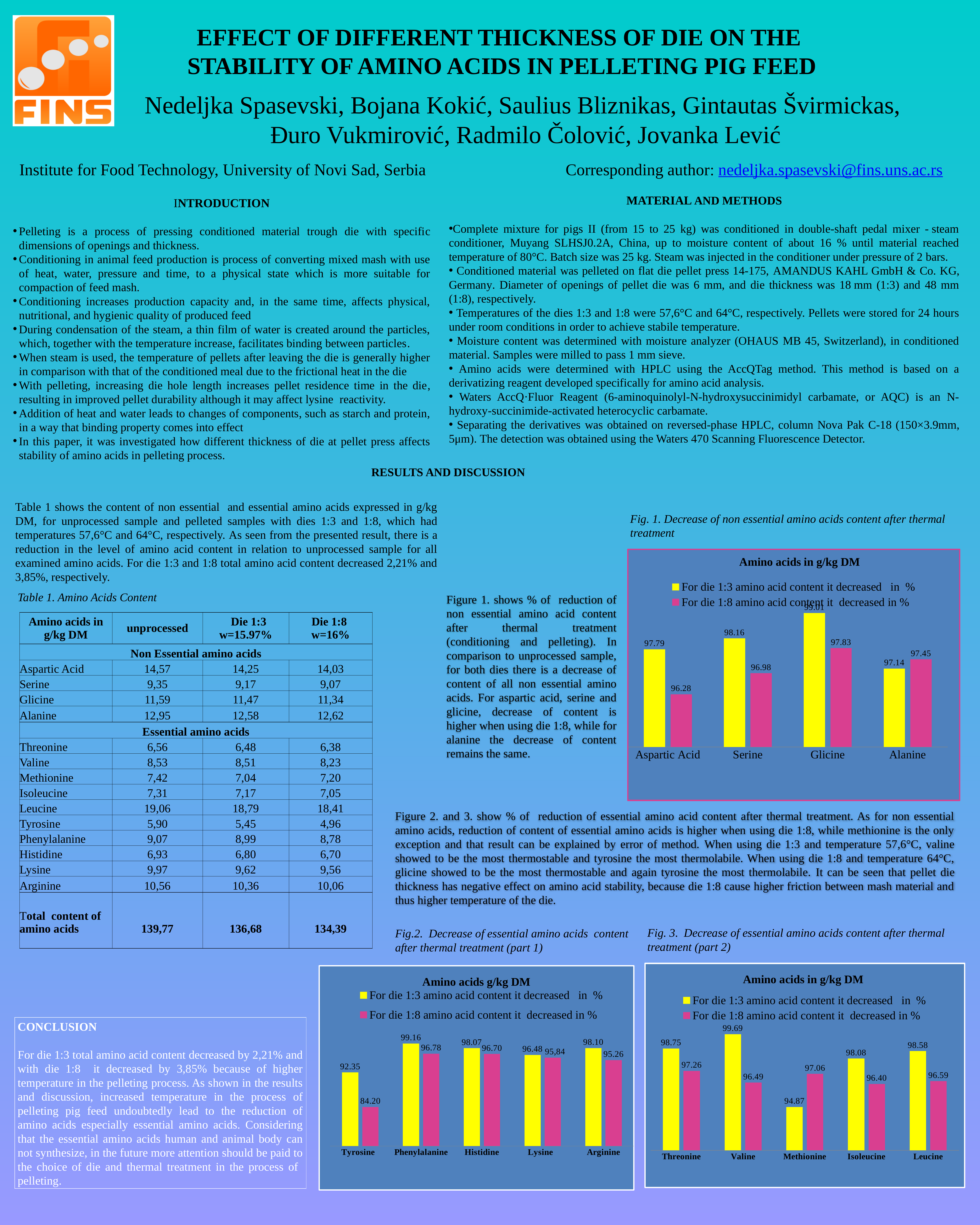
In Fig. 3 (Decrease of essential amino acids content, part 2), what is the value for Valine for die 1:3? 99.69 In Fig. 2 (essential amino acids, part 1), which amino acid has the highest value for die 1:3? Phenylalanine In Fig. 3 (essential amino acids, part 2), for Methionine, which is larger: the die 1:3 value or the die 1:8 value? die 1:8 In Fig. 2 (essential amino acids, part 1), what is the difference between the die 1:3 and die 1:8 values for Tyrosine? 8.15 In Fig. 2 (Decrease of essential amino acids content, part 1), what is the value for Tyrosine for die 1:8? 84.20 In Fig. 1 (non essential amino acids), what is the value for Alanine for die 1:8? 97.45 In Fig. 1 (non essential amino acids), how many series does the legend list? 2 In Fig. 1 (Decrease of non essential amino acids content after thermal treatment), what is the value for Aspartic Acid for die 1:3? 97.79 In Fig. 2 (essential amino acids, part 1), how many amino acids are shown on the x axis? 5 In Fig. 1 (non essential amino acids), which amino acid has the lowest value for die 1:8? Aspartic Acid In Fig. 3 (essential amino acids, part 2), which amino acid has the lowest value for die 1:3? Methionine What type of chart is Fig. 3 (essential amino acids, part 2)? bar chart